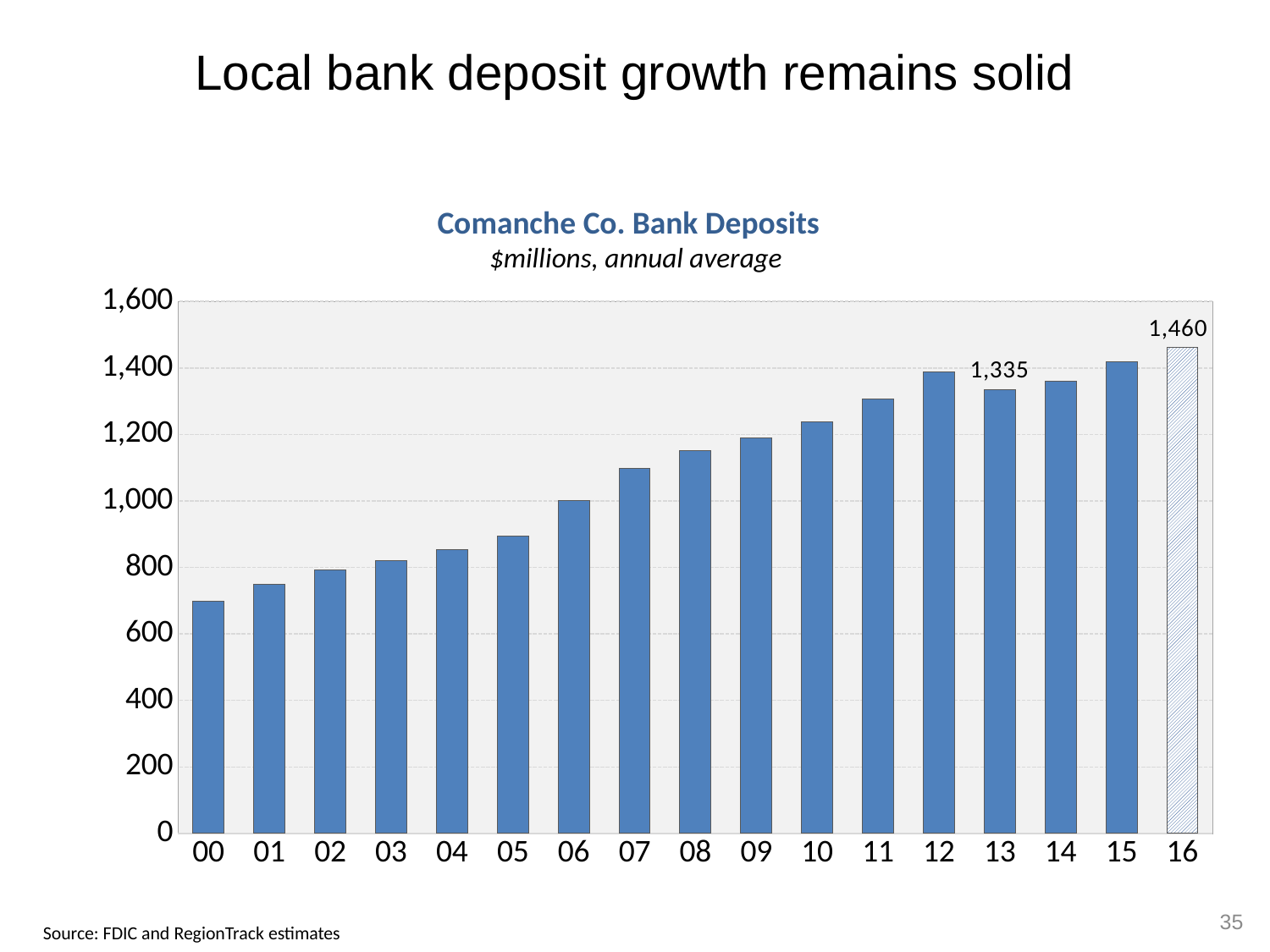
Is the value for 07 greater or less than 1,000? greater Is the value for 00 greater or less than 800? less Which is larger, the value for 12 or the value for 13? 12 What is the value for 13 in the Comanche Co. Bank Deposits chart? 1,335 Do the bank deposit values generally rise or fall from 00 to 16? rise How many years are shown on the x axis? 17 Which year has the highest bank deposits? 16 What units are the bank deposits shown in, according to the chart subtitle? $millions, annual average What is the difference between the values for 16 and 13? 125 Which year has the lowest bank deposits? 00 What kind of chart is shown on the slide? bar chart What is the value for 16 in the Comanche Co. Bank Deposits chart? 1,460